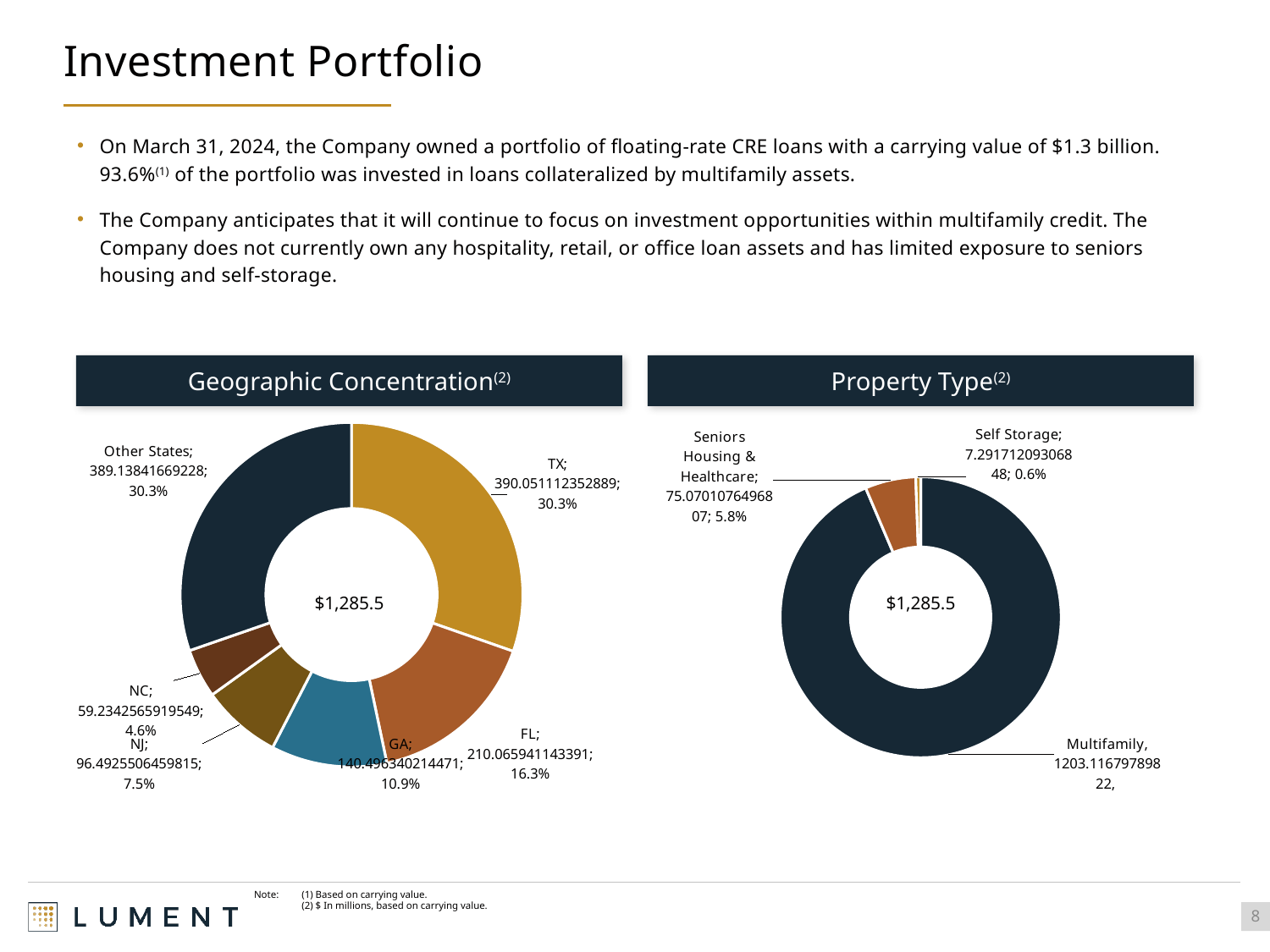
What kind of chart is the Geographic Concentration chart? Pie (donut) chart On the Property Type chart, what share of the portfolio is Seniors Housing & Healthcare? 5.8% On the Geographic Concentration chart, which state has the smallest share? NC On the Geographic Concentration chart, which is larger, FL or GA? FL On the Geographic Concentration chart, what is the difference in percentage points between FL and GA? 5.4 percentage points On the Geographic Concentration chart, what share of the portfolio is in FL? 16.3% On the Geographic Concentration chart, what share of the portfolio is in GA? 10.9% On the Property Type chart, what share of the portfolio is Self Storage? 0.6% On the Geographic Concentration chart, what share of the portfolio is in NJ? 7.5% On the Property Type chart, which property type has the largest share? Multifamily How many categories are shown on the Geographic Concentration chart? 6 What total value is shown in the center of the Property Type chart? $1,285.5